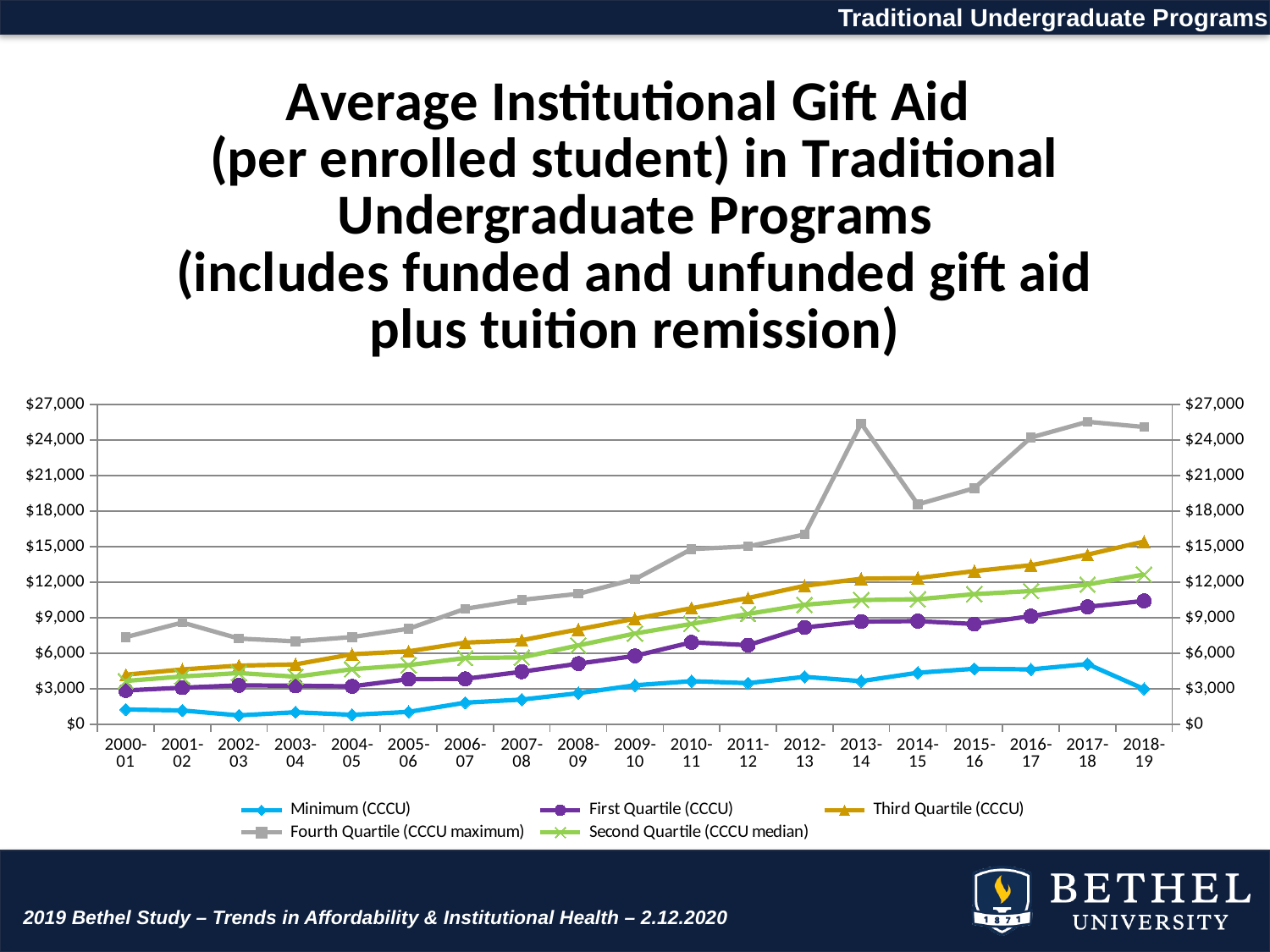
What kind of chart is shown on the slide? line chart Which is larger for Minimum (CCCU): the value in 2017-18 or the value in 2018-19? 2017-18 Is the value for Minimum (CCCU) in 2002-03 greater or less than $3,000? less Which series is drawn with a grey line and square markers? Fourth Quartile (CCCU maximum) Which series has the lowest value in 2018-19? Minimum (CCCU) Is the value for Third Quartile (CCCU) in 2018-19 greater or less than $12,000? greater How many academic years are plotted along the x axis? 19 Which is larger for Fourth Quartile (CCCU maximum): the value in 2013-14 or the value in 2014-15? 2013-14 Which series has the highest value in 2018-19? Fourth Quartile (CCCU maximum) How many series does the legend list? 5 Does the Third Quartile (CCCU) series generally rise or fall from 2000-01 to 2018-19? rise Is the value for Fourth Quartile (CCCU maximum) in 2013-14 greater or less than $24,000? greater